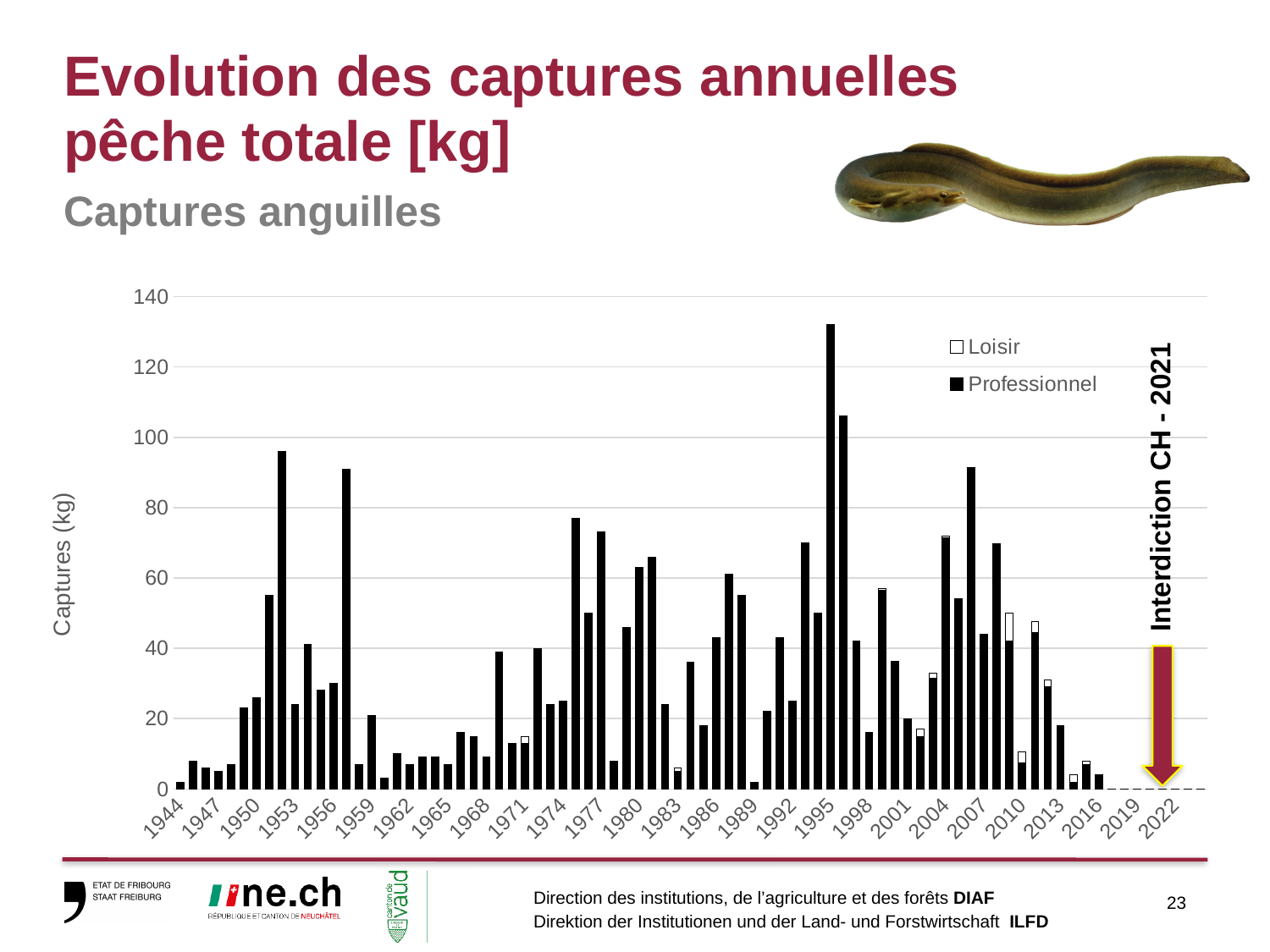
What are the two series named in the legend? Loisir and Professionnel What type of chart is shown on the slide? bar chart Which year has the highest total captures? 1995 Is the total value for 1944 greater or less than 20? less Is the total value for 2016 greater or less than 20? less How many series does the legend list? 2 Is the total value for 1952 greater or less than 80? greater What is the label of the vertical axis? Captures (kg) Which year has the larger total captures, 1995 or 1996? 1995 Which year has the larger total captures, 1944 or 1995? 1995